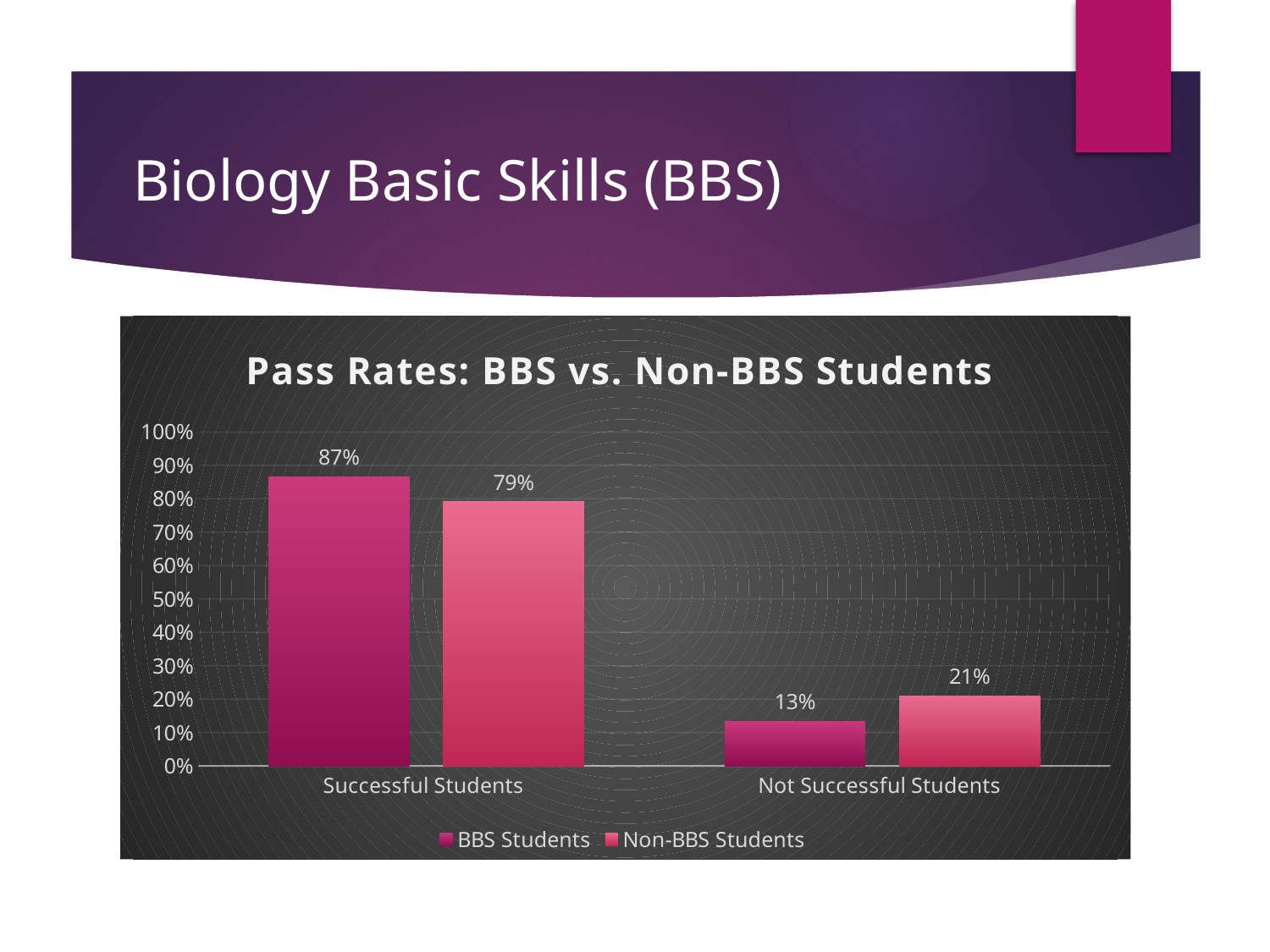
What is the difference between the BBS Students and Non-BBS Students values for Successful Students? 8% Which series has the higher value in the Successful Students category? BBS Students How many series does the legend list? 2 What is the value for BBS Students in the Not Successful Students category? 13% Which series has the lower value in the Not Successful Students category? BBS Students How many categories are shown on the x axis? 2 What is the value for BBS Students in the Successful Students category? 87% What is the title of the chart? Pass Rates: BBS vs. Non-BBS Students What is the value for Non-BBS Students in the Not Successful Students category? 21% What kind of chart is shown on the slide? Bar chart What is the value for Non-BBS Students in the Successful Students category? 79% What is the difference between the Non-BBS Students and BBS Students values for Not Successful Students? 8%